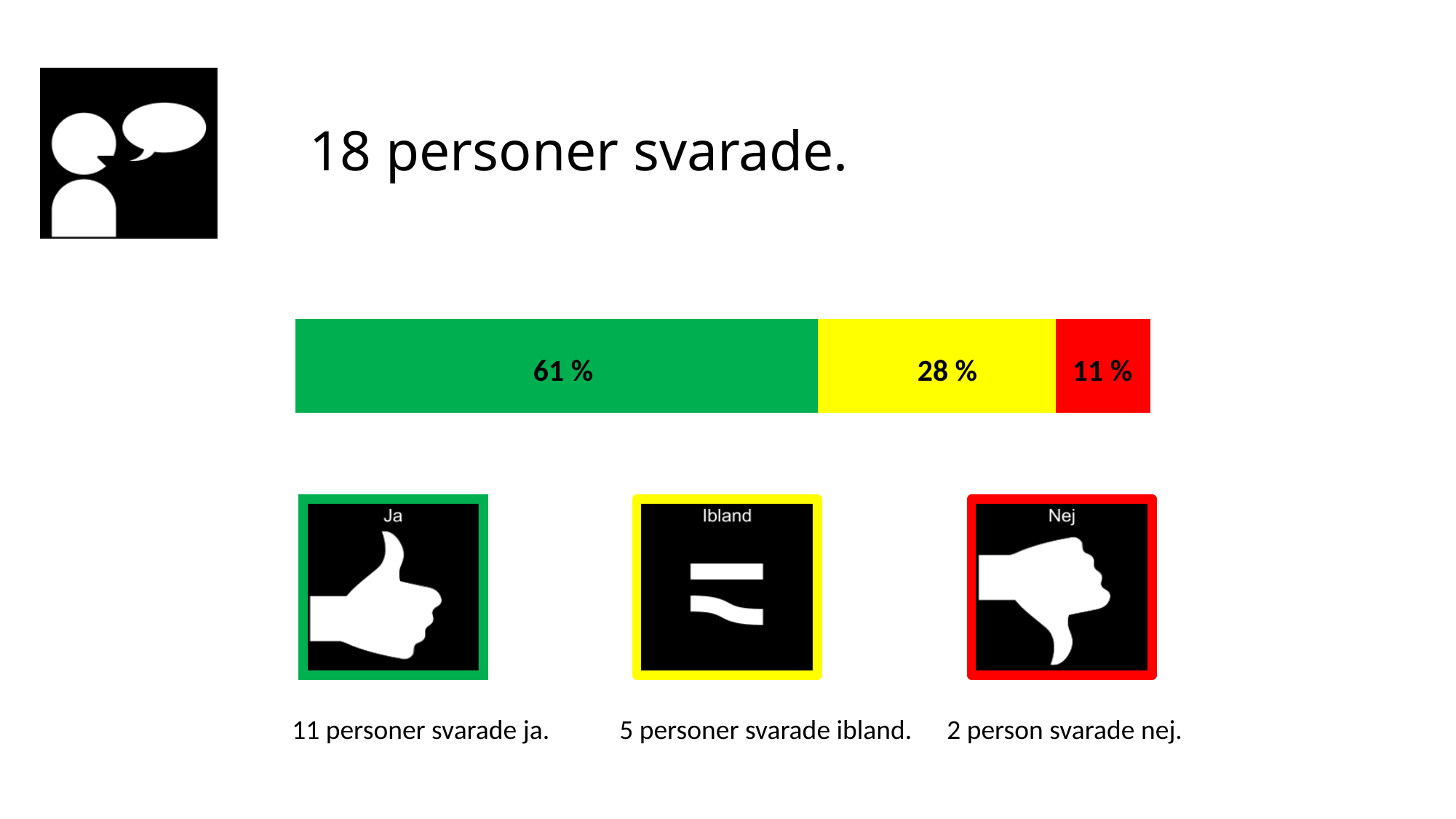
What is the difference in percentage points between the yellow segment and the red segment? 17 What colour is the segment representing 'Nej'? red Which segment is larger, the yellow one or the red one? yellow What kind of chart is shown on the slide? bar chart What percentage is shown in the yellow segment of the bar? 28 % How many segments does the stacked bar have? 3 What is the total of the three percentages in the stacked bar? 100 % What percentage is shown in the red segment of the bar? 11 % Which response category has the smallest share of the bar? Nej What percentage is shown in the green segment of the bar? 61 % What is the difference in percentage points between the green segment and the yellow segment? 33 Which response category has the largest share of the bar? Ja